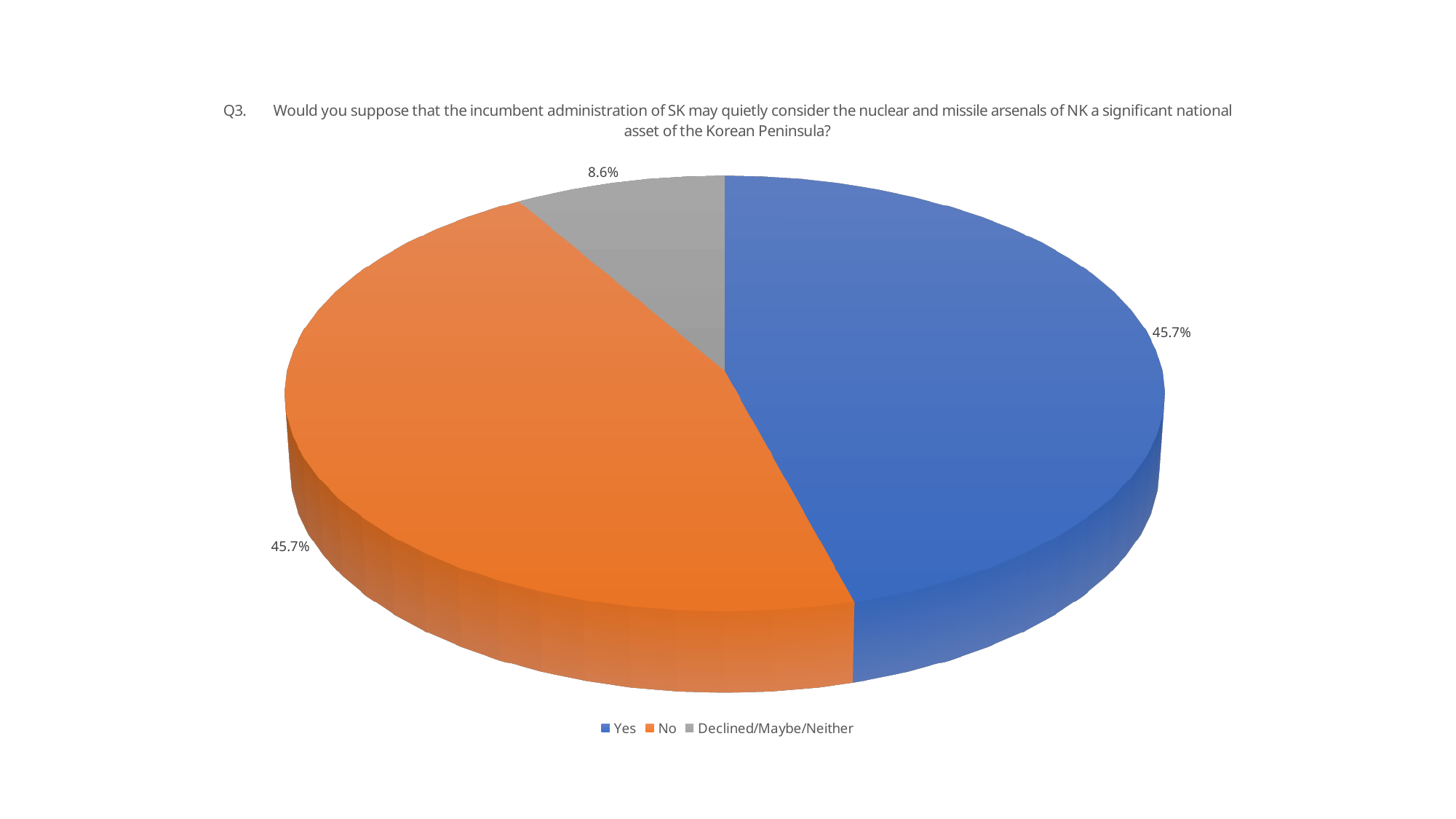
What share of the pie does the "No" slice represent? 45.7% How many entries does the legend list? 3 What is the combined share of the "Yes" and "No" slices? 91.4% How many categories does the pie chart show? 3 What share of the pie does the "Yes" slice represent? 45.7% What kind of chart is shown on the slide? pie chart What share of the pie does the "Declined/Maybe/Neither" slice represent? 8.6% What is the difference between the "Yes" share and the "Declined/Maybe/Neither" share? 37.1% Which category is shown in grey in the chart? Declined/Maybe/Neither Which category has the smallest slice of the pie? Declined/Maybe/Neither Which colour represents the "No" category in the chart? orange Is the "No" slice larger or smaller than the "Declined/Maybe/Neither" slice? larger